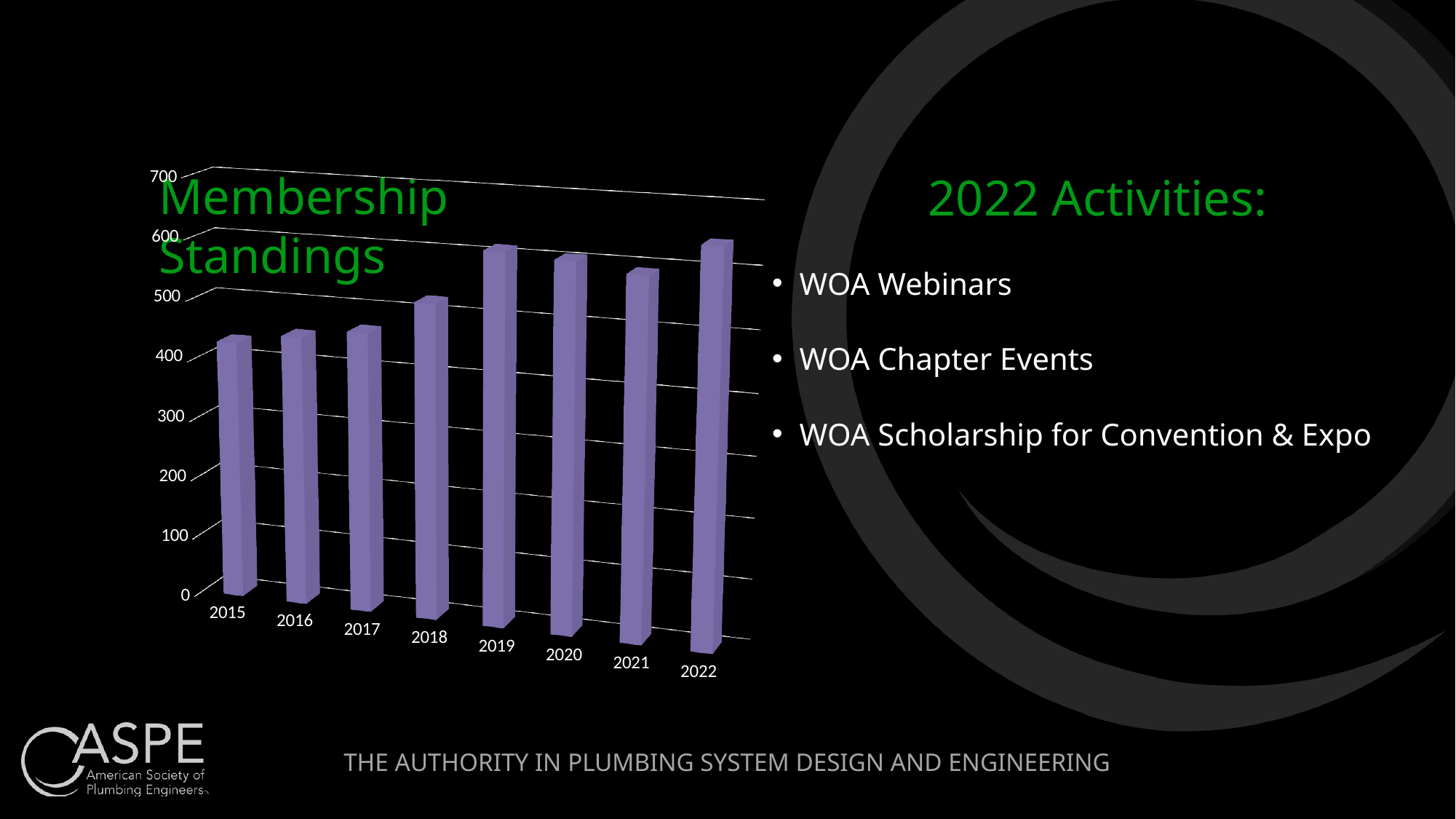
Is the value for 2015 greater or less than 500? less Is the value for 2021 greater or less than 500? greater Which is larger, the value for 2019 or the value for 2015? 2019 How many years are plotted on the Membership Standings chart? 8 What kind of chart is shown on the slide? bar chart Do the values generally rise or fall from 2015 to 2022? rise Is the value for 2019 greater or less than 500? greater Which year has the highest bar on the Membership Standings chart? 2022 What is the title of the chart on the slide? Membership Standings Which year has the lowest bar on the Membership Standings chart? 2015